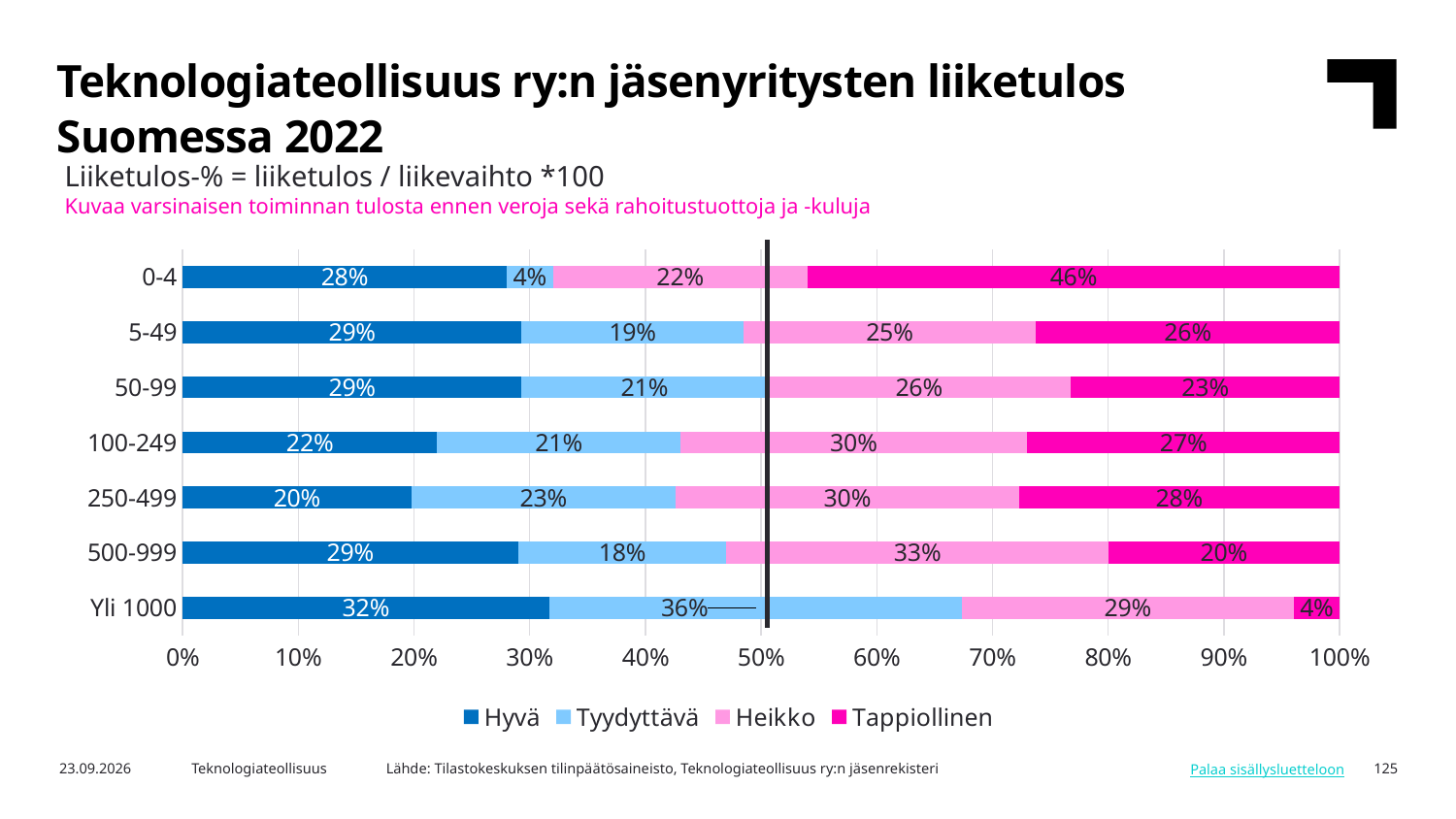
What is the Tyydyttävä share for the 500-999 size class? 18% Which size class has the lowest Tappiollinen share? Yli 1000 Which size class has the highest Hyvä share? Yli 1000 What is the Heikko share for the 100-249 size class? 30% How many size classes are shown on the chart? 7 How many series does the legend list? 4 What is the Tappiollinen share for the 0-4 size class? 46% What kind of chart is shown on the slide? Stacked bar chart What is the difference between the Tappiollinen share of the 0-4 class and that of the 5-49 class? 20 percentage points What is the Hyvä share for the Yli 1000 size class? 32% Which is larger: the Heikko share for 500-999 or the Heikko share for 50-99? 500-999 Which size class has the highest Tappiollinen share? 0-4